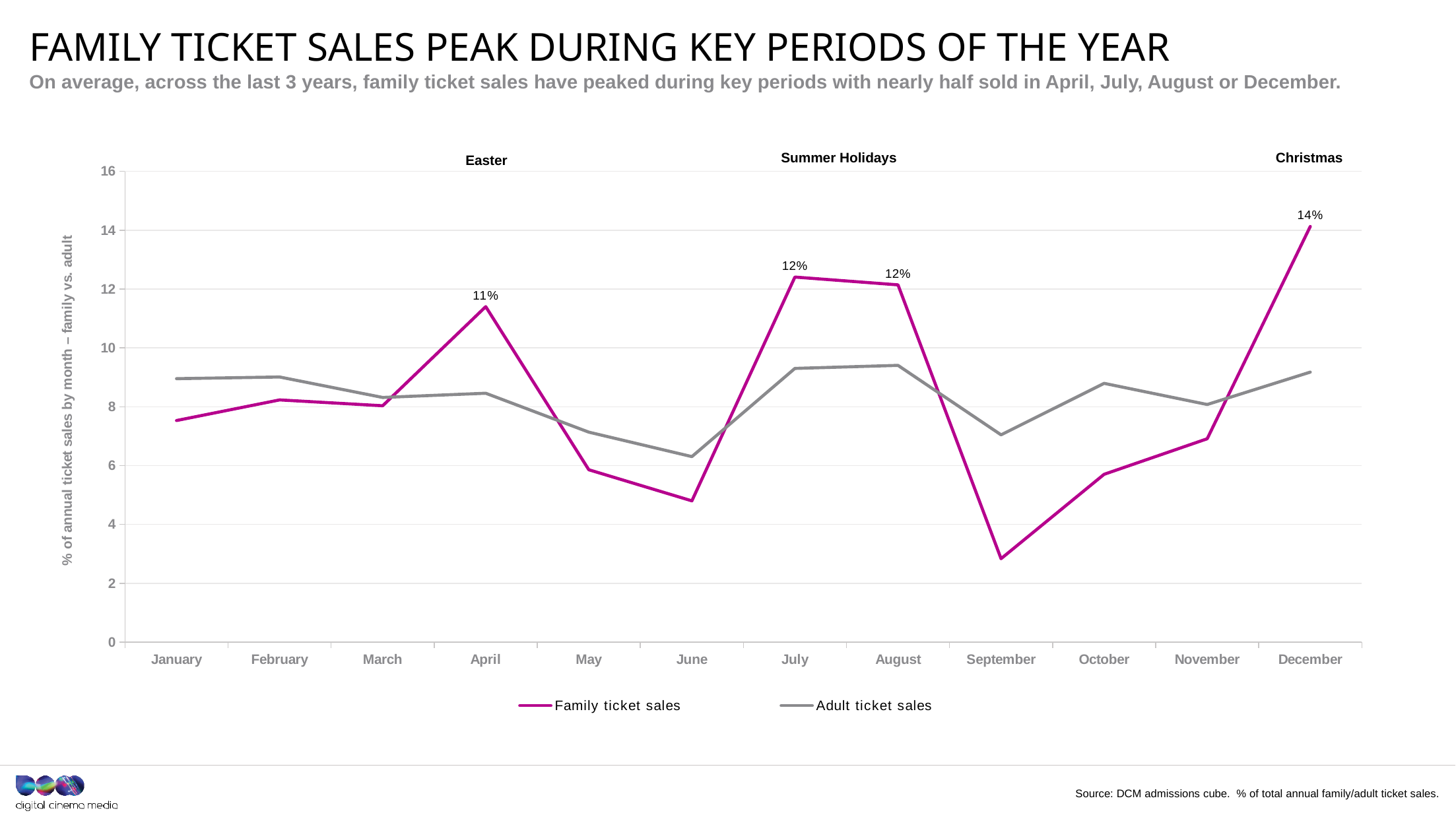
What is the difference between the Family ticket sales values for December and April? 3% Is the value for Family ticket sales in September greater or less than 4? less Is the value for Adult ticket sales in June greater or less than 8? less Do Family ticket sales rise or fall from September to December? rise In which month are Family ticket sales lowest? September How many months are shown on the x axis of the chart? 12 In which month are Family ticket sales highest? December What is the value for Family ticket sales in December? 14% In July, which series has the larger value, Family ticket sales or Adult ticket sales? Family ticket sales What kind of chart is shown on the slide? line chart How many series does the legend list? 2 What is the value for Family ticket sales in April? 11%